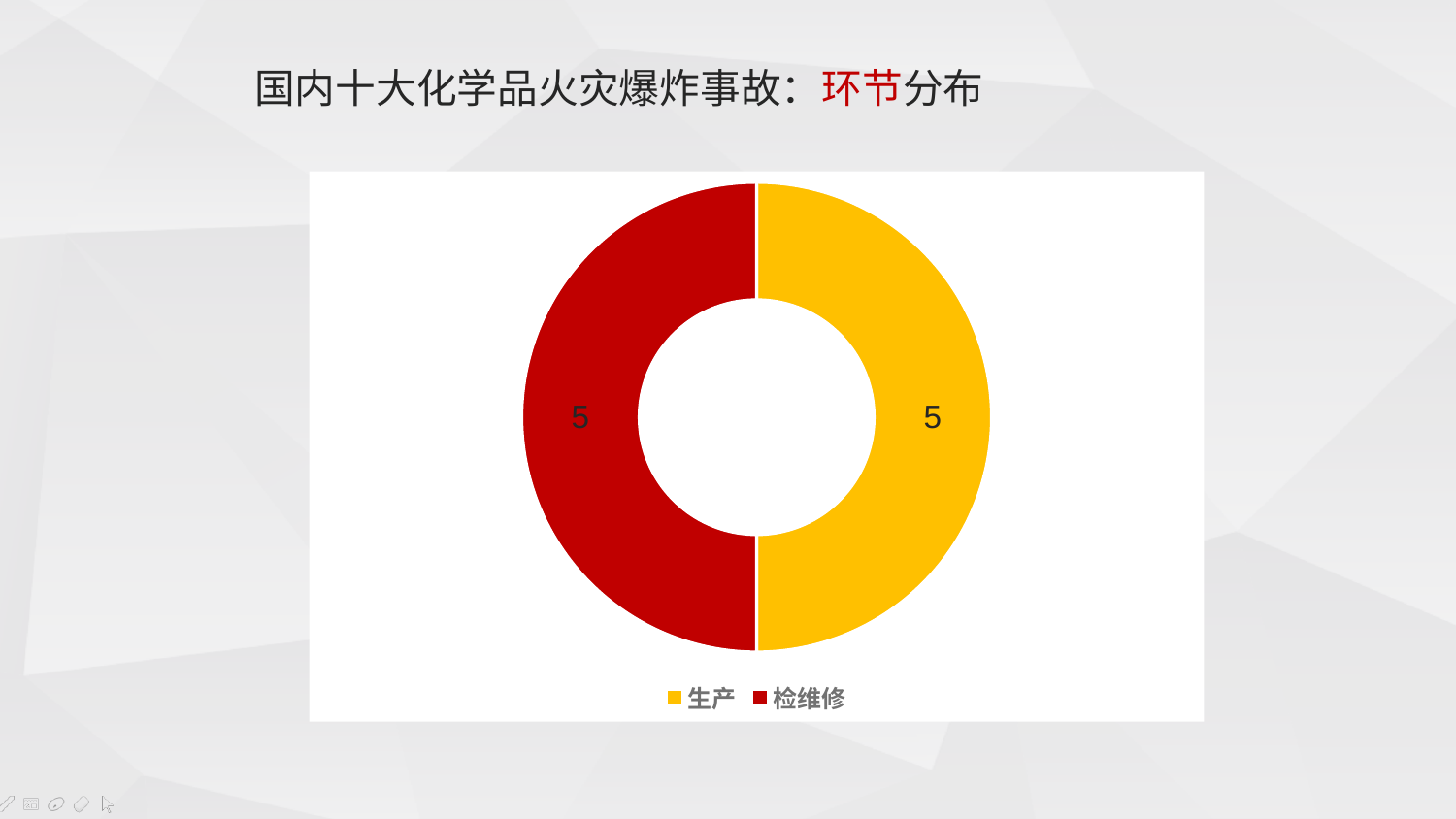
What share of the chart does the 生产 slice represent? 50% What is the difference between the values for 生产 and 检维修? 0 What share of the chart does the 检维修 slice represent? 50% Which colour represents 检维修 in the chart? Red How many entries does the legend list? 2 What is the title of the slide containing the chart? 国内十大化学品火灾爆炸事故：环节分布 What is the value for 生产? 5 What kind of chart is shown on the slide? Doughnut (pie) chart What is the value for 检维修? 5 How many categories does the chart show? 2 What is the total of all slices in the chart? 10